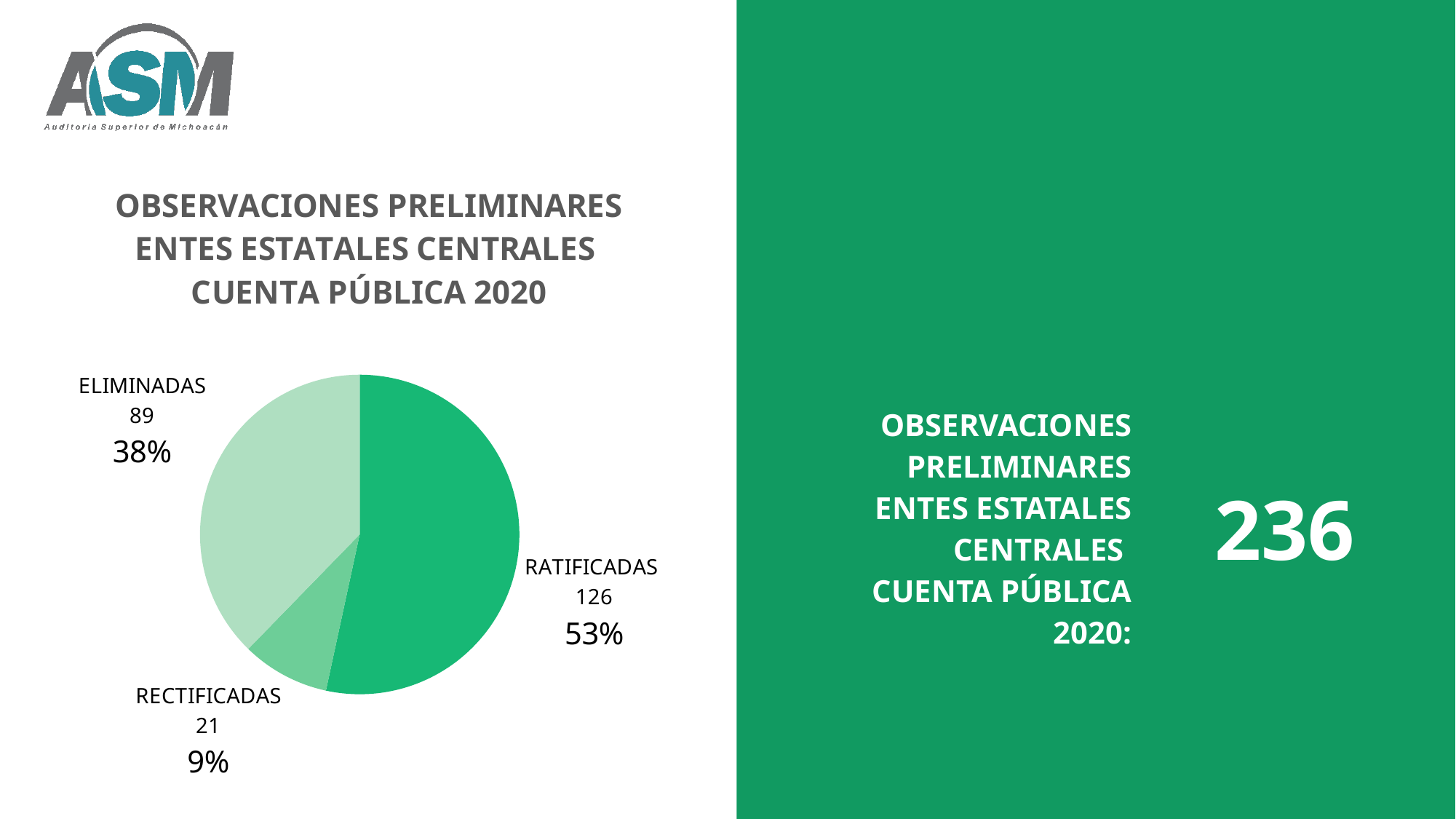
Which is larger, ELIMINADAS or RECTIFICADAS? ELIMINADAS Which category has the largest slice? RATIFICADAS How many slices does the pie chart have? 3 Which category has the smallest slice? RECTIFICADAS What is the value for RECTIFICADAS? 21 What kind of chart is shown on the slide? pie chart What share of the pie does RATIFICADAS represent? 53% What is the title of the chart? OBSERVACIONES PRELIMINARES ENTES ESTATALES CENTRALES CUENTA PÚBLICA 2020 What is the value for RATIFICADAS? 126 What share of the pie does RECTIFICADAS represent? 9% What is the difference between the values for RATIFICADAS and ELIMINADAS? 37 What is the value for ELIMINADAS? 89